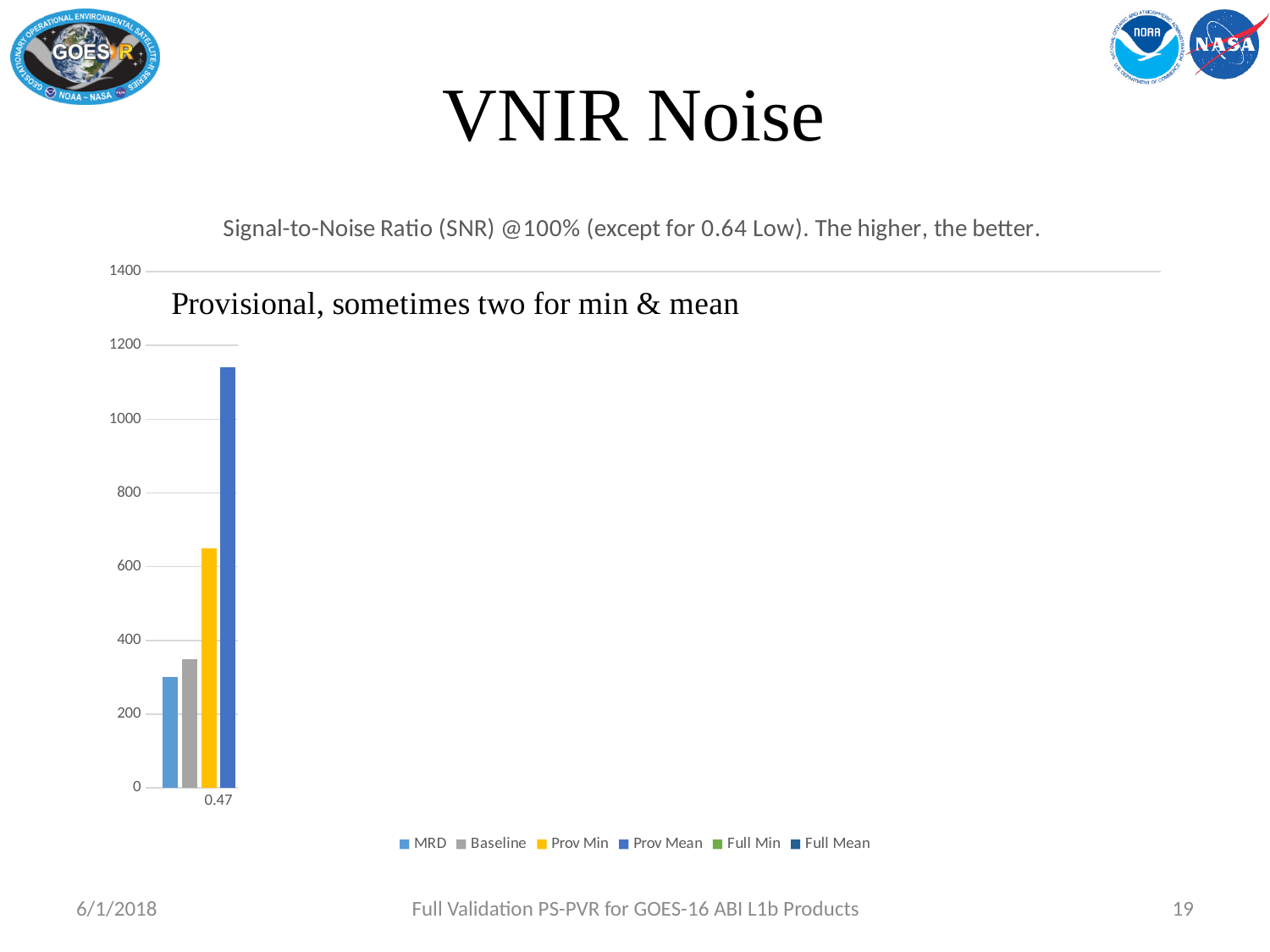
Which series has the lowest bar for the 0.47 category? MRD How many categories are plotted on the x axis of the chart? 1 Is the Prov Mean value for 0.47 greater or less than 1000? greater Is the Prov Min value for 0.47 greater or less than 600? greater What is the category label shown on the x axis? 0.47 Is the Baseline value for 0.47 greater or less than 400? less What kind of chart is shown on the slide? bar chart What is the title of the chart? Signal-to-Noise Ratio (SNR) @100% (except for 0.64 Low). The higher, the better. For the 0.47 category, which is larger: the Prov Min value or the Baseline value? Prov Min Which series has the highest bar for the 0.47 category? Prov Mean How many series does the chart legend list? 6